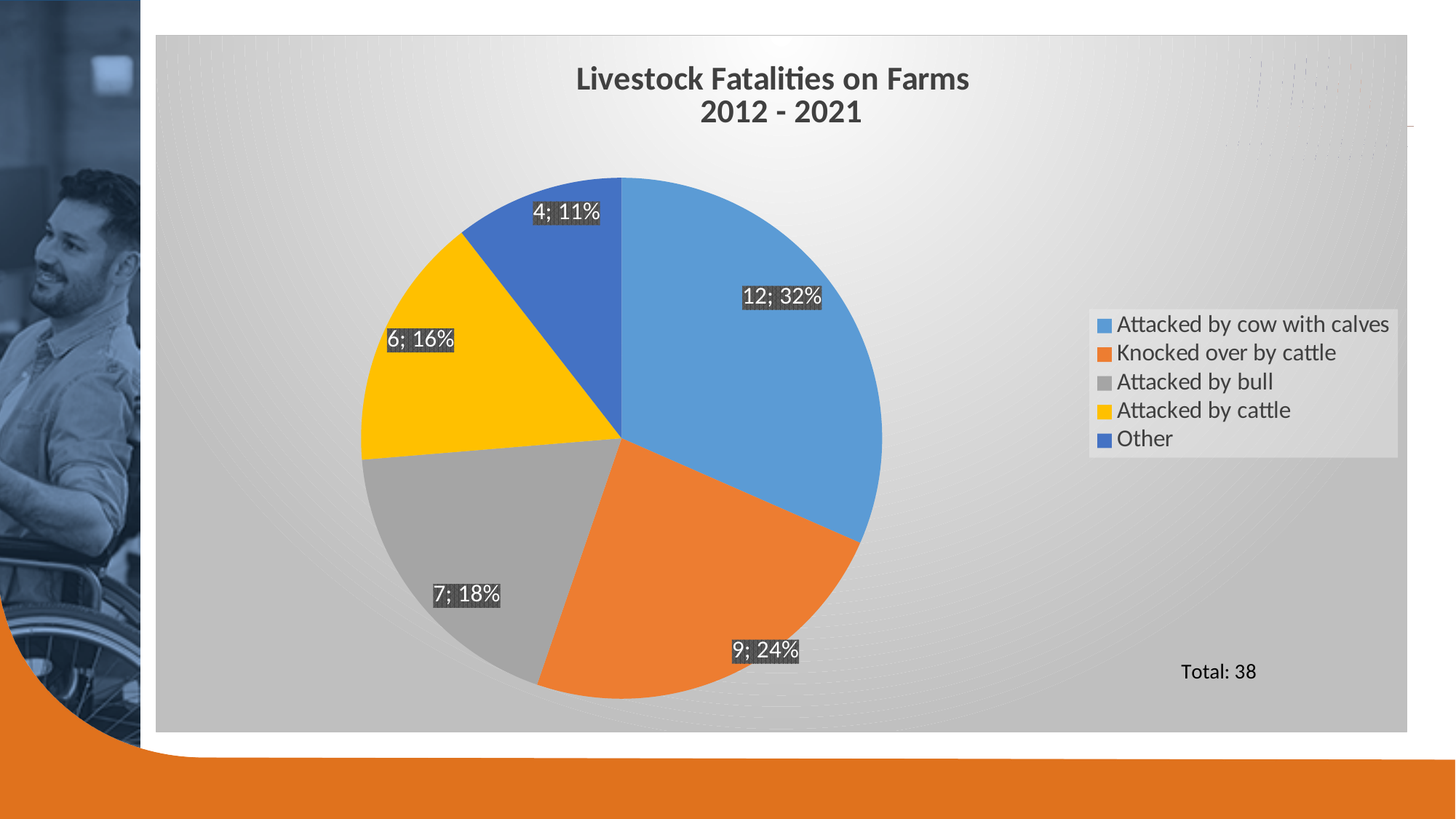
How many fatalities are attributed to 'Attacked by cow with calves'? 12 What is the difference in fatalities between 'Attacked by cow with calves' and 'Attacked by cattle'? 6 How many fatalities are attributed to 'Attacked by bull'? 7 Which category has the smallest slice? Other What kind of chart is shown on the slide? Pie chart What is the total number of fatalities shown on the slide? 38 What percentage share does 'Other' have? 11% How many categories does the pie chart have? 5 Which category has the largest slice? Attacked by cow with calves What percentage share does 'Knocked over by cattle' have? 24% Which is larger, 'Knocked over by cattle' or 'Attacked by bull'? Knocked over by cattle What is the title of the chart? Livestock Fatalities on Farms 2012 - 2021